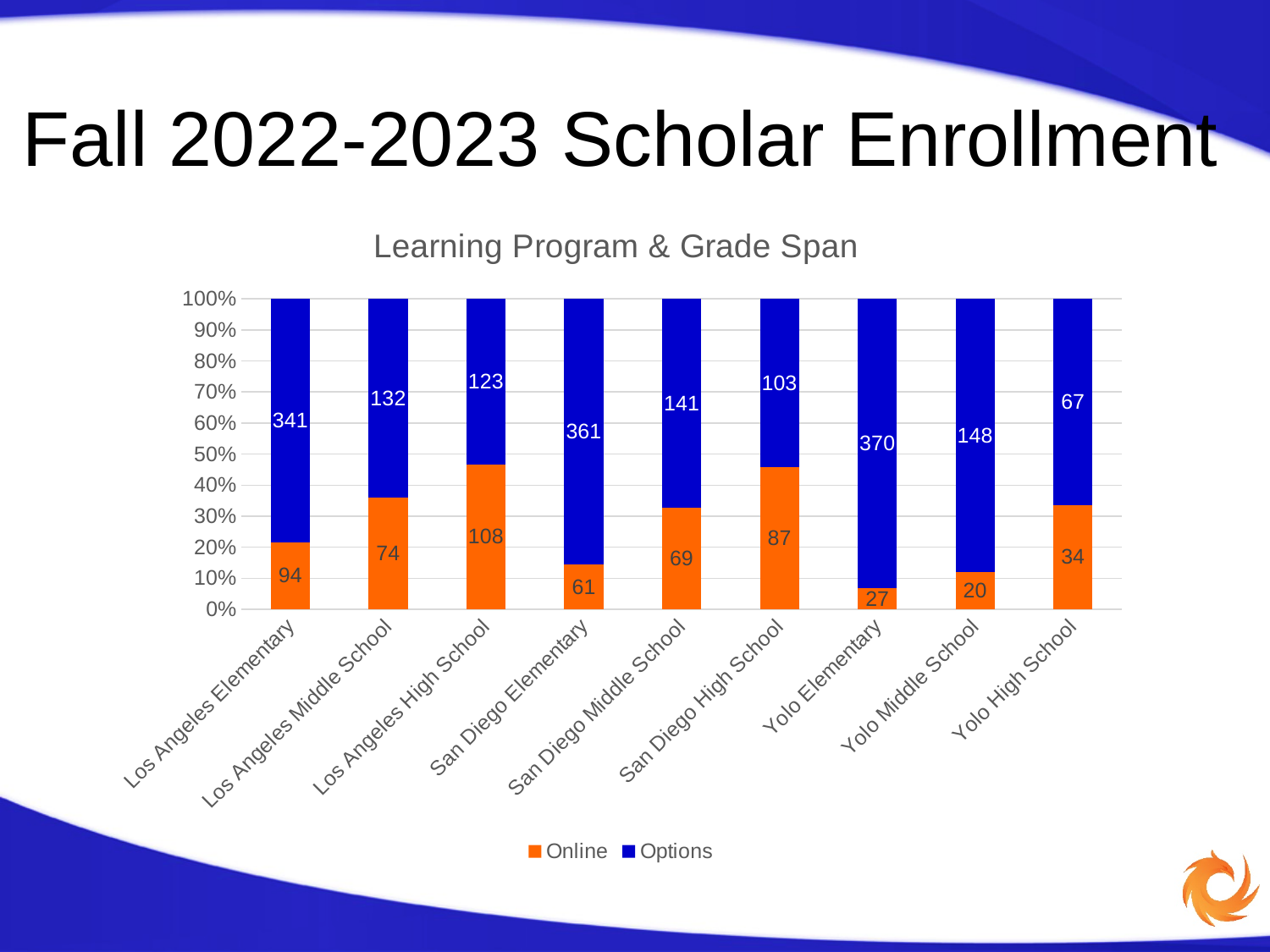
What is the Options enrollment for San Diego Elementary? 361 Which category has the lowest Online enrollment? Yolo Middle School What kind of chart is shown on the slide? Stacked bar chart Which category has the highest Options enrollment? Yolo Elementary What is the total enrollment (Online plus Options) for Yolo Middle School? 168 What is the Online enrollment for Yolo High School? 34 Which is larger, the Online enrollment for San Diego High School or the Online enrollment for San Diego Middle School? San Diego High School How many series does the legend list? 2 How many categories are shown on the x axis? 9 What is the title of the chart? Learning Program & Grade Span What is the difference between the Options and Online enrollment for Los Angeles High School? 15 What is the Online enrollment for Los Angeles Elementary? 94